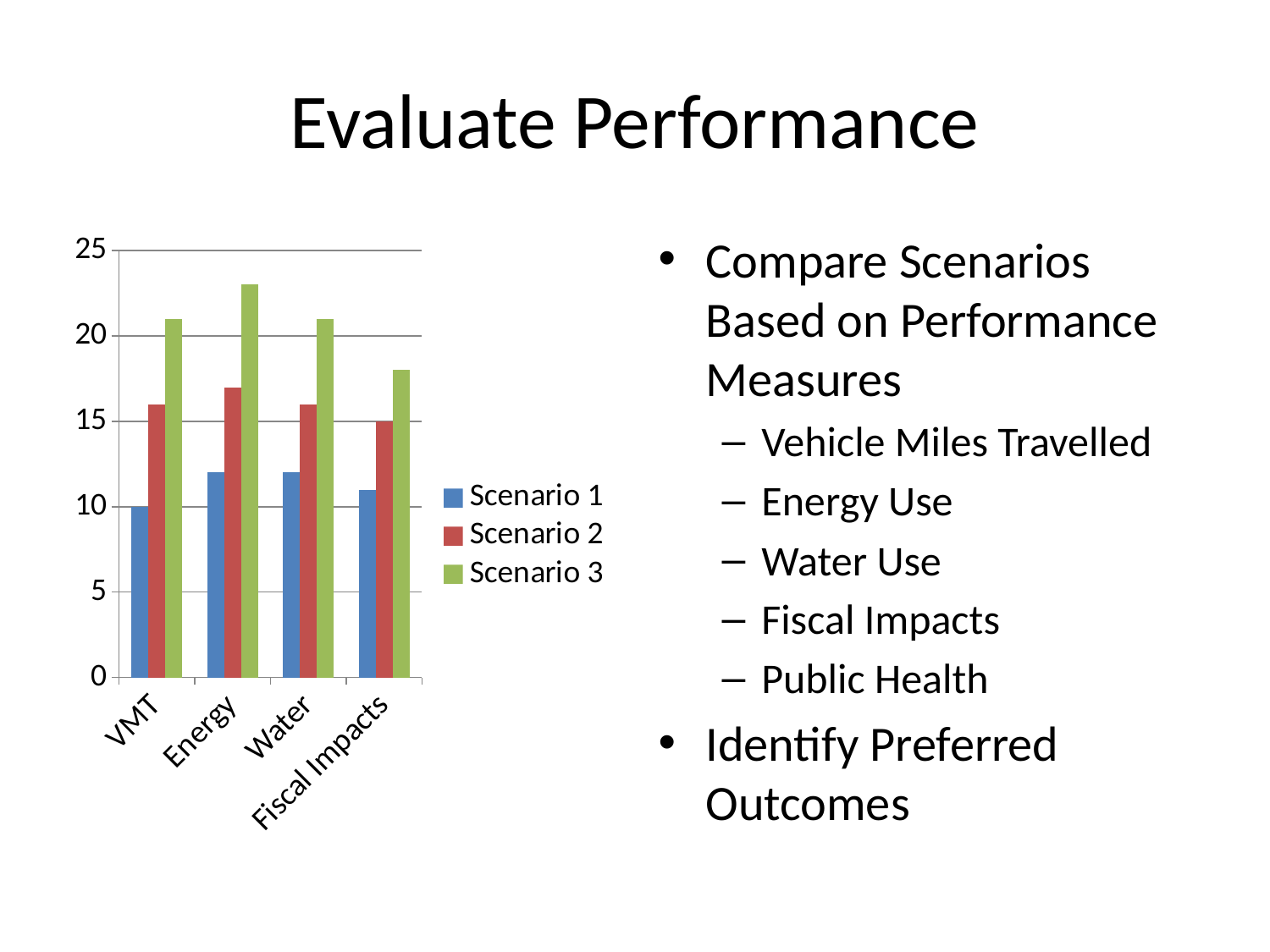
What kind of chart is shown on the slide? bar chart Which category has the highest Scenario 3 bar? Energy How many categories are shown on the x axis of the chart? 4 Is the Scenario 1 value for Fiscal Impacts greater or less than 15? less Is the Scenario 2 value for VMT greater or less than 20? less How many series does the chart's legend list? 3 For Water, which is larger: the Scenario 1 bar or the Scenario 3 bar? Scenario 3 What are the three entries listed in the chart's legend? Scenario 1, Scenario 2, Scenario 3 What is the Scenario 1 value for VMT? 10 For Scenario 2, which category has the larger bar: Energy or Fiscal Impacts? Energy Is the Scenario 3 value for Energy greater or less than 20? greater Which category has the lowest Scenario 1 bar? VMT